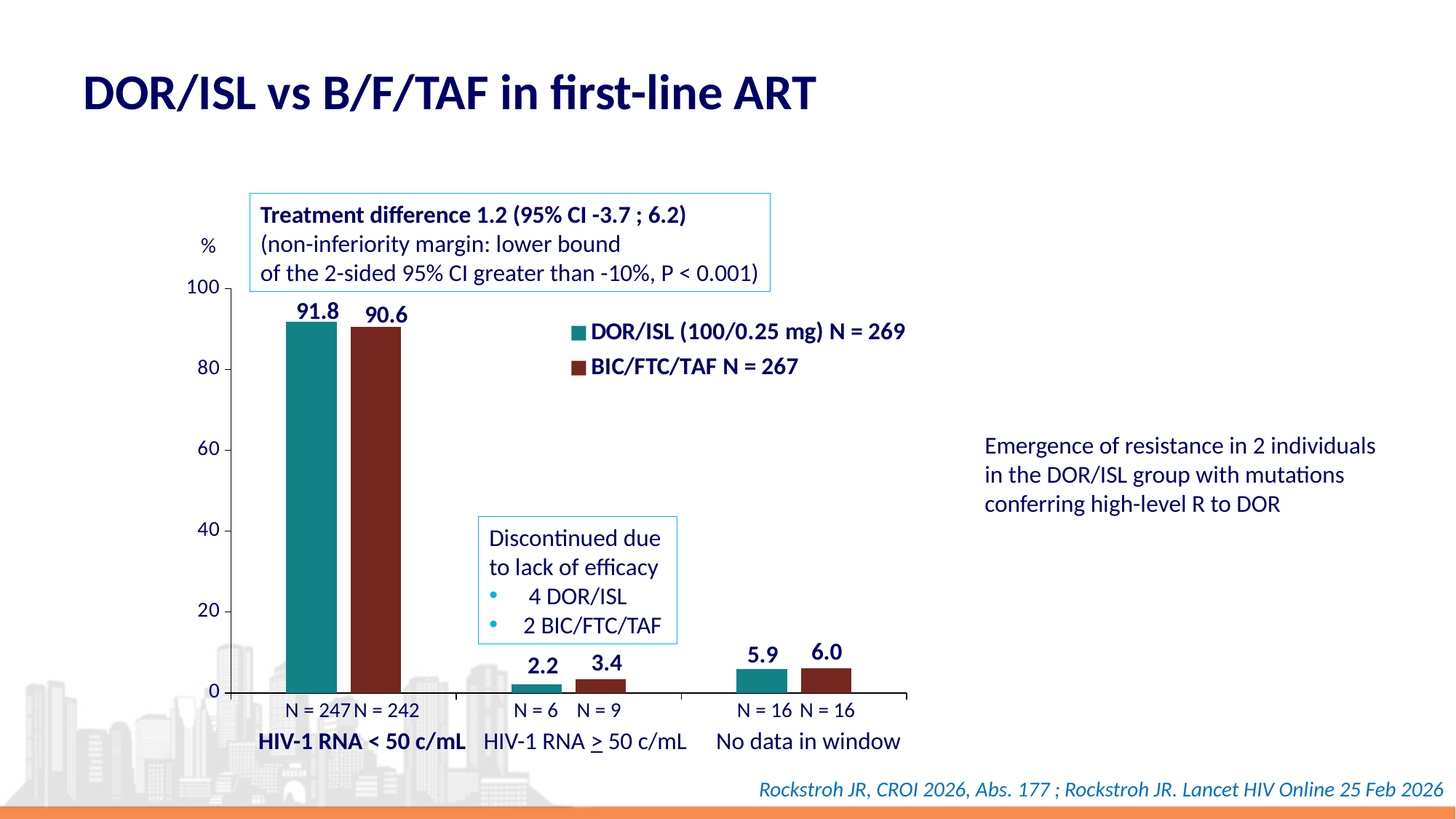
Which category has the highest value for DOR/ISL? HIV-1 RNA < 50 c/mL What is the value for DOR/ISL in the HIV-1 RNA < 50 c/mL category? 91.8 How many series does the legend list? 2 What is the value for DOR/ISL in the HIV-1 RNA ≥ 50 c/mL category? 2.2 What is the value for BIC/FTC/TAF in the No data in window category? 6.0 In the HIV-1 RNA ≥ 50 c/mL category, which series has the larger value, DOR/ISL or BIC/FTC/TAF? BIC/FTC/TAF What is the N shown under the DOR/ISL bar in the No data in window category? N = 16 How many categories are shown on the x axis? 3 What is the difference between the DOR/ISL and BIC/FTC/TAF values in the HIV-1 RNA < 50 c/mL category? 1.2 Which category has the lowest value for BIC/FTC/TAF? HIV-1 RNA ≥ 50 c/mL What kind of chart is shown on the slide? Bar chart What is the value for BIC/FTC/TAF in the HIV-1 RNA < 50 c/mL category? 90.6